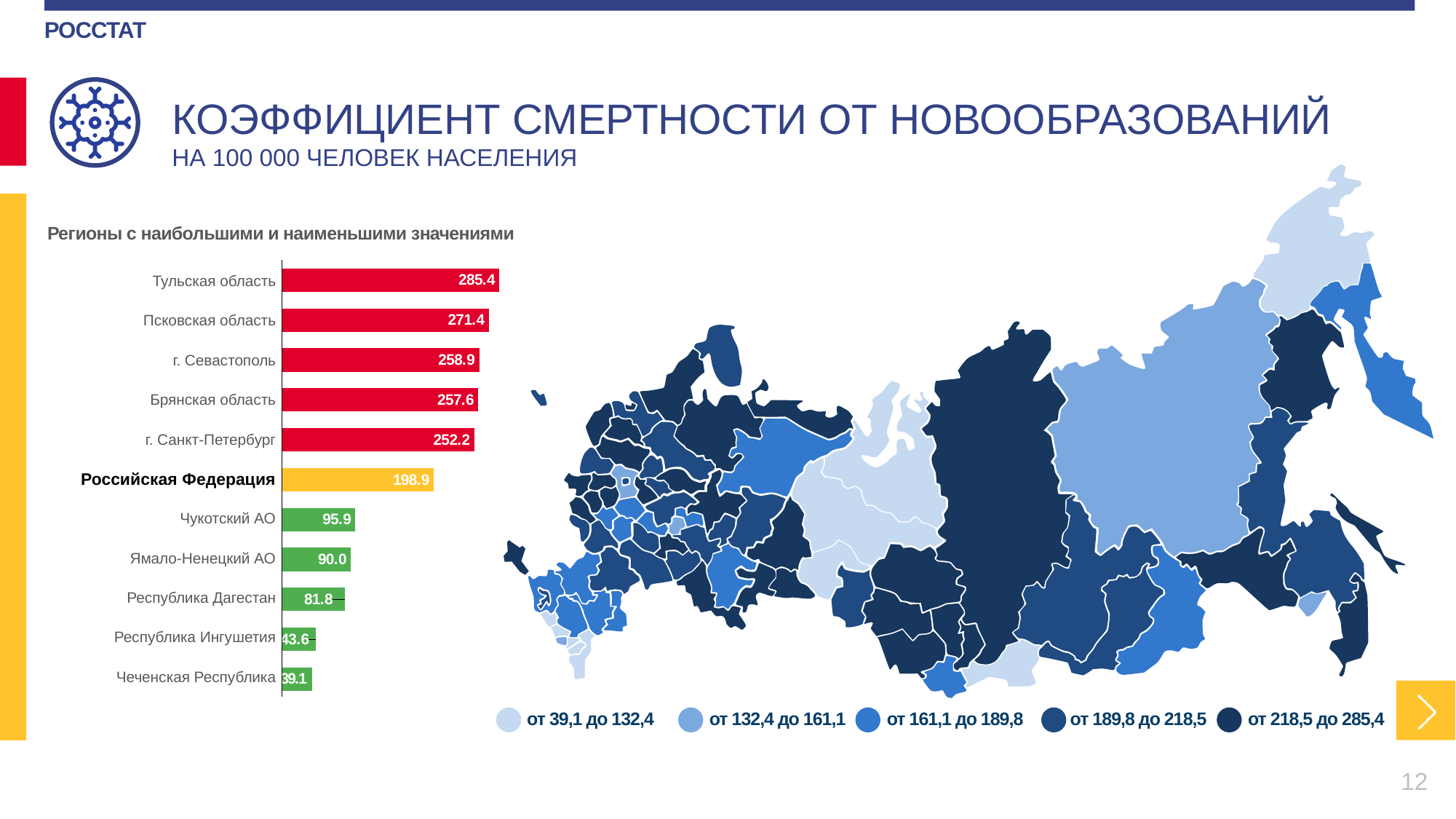
In the bar chart, what is the difference between the values for Тульская область and Псковская область? 14.0 In the bar chart, which is larger: the value for Ямало-Ненецкий АО or the value for Республика Ингушетия? Ямало-Ненецкий АО In the bar chart, what is the value for Республика Дагестан? 81.8 In the bar chart, what is the value for Российская Федерация? 198.9 How many regions (bars) are shown in the bar chart? 11 What kind of chart is shown on the left of the slide? bar chart In the bar chart, which region has the highest value? Тульская область How many value ranges does the map legend list? 5 In the bar chart, which is larger: the value for г. Севастополь or the value for г. Санкт-Петербург? г. Севастополь In the bar chart, what is the difference between the values for Российская Федерация and Чукотский АО? 103.0 In the bar chart, what is the value for Тульская область? 285.4 In the bar chart, which region has the lowest value? Чеченская Республика